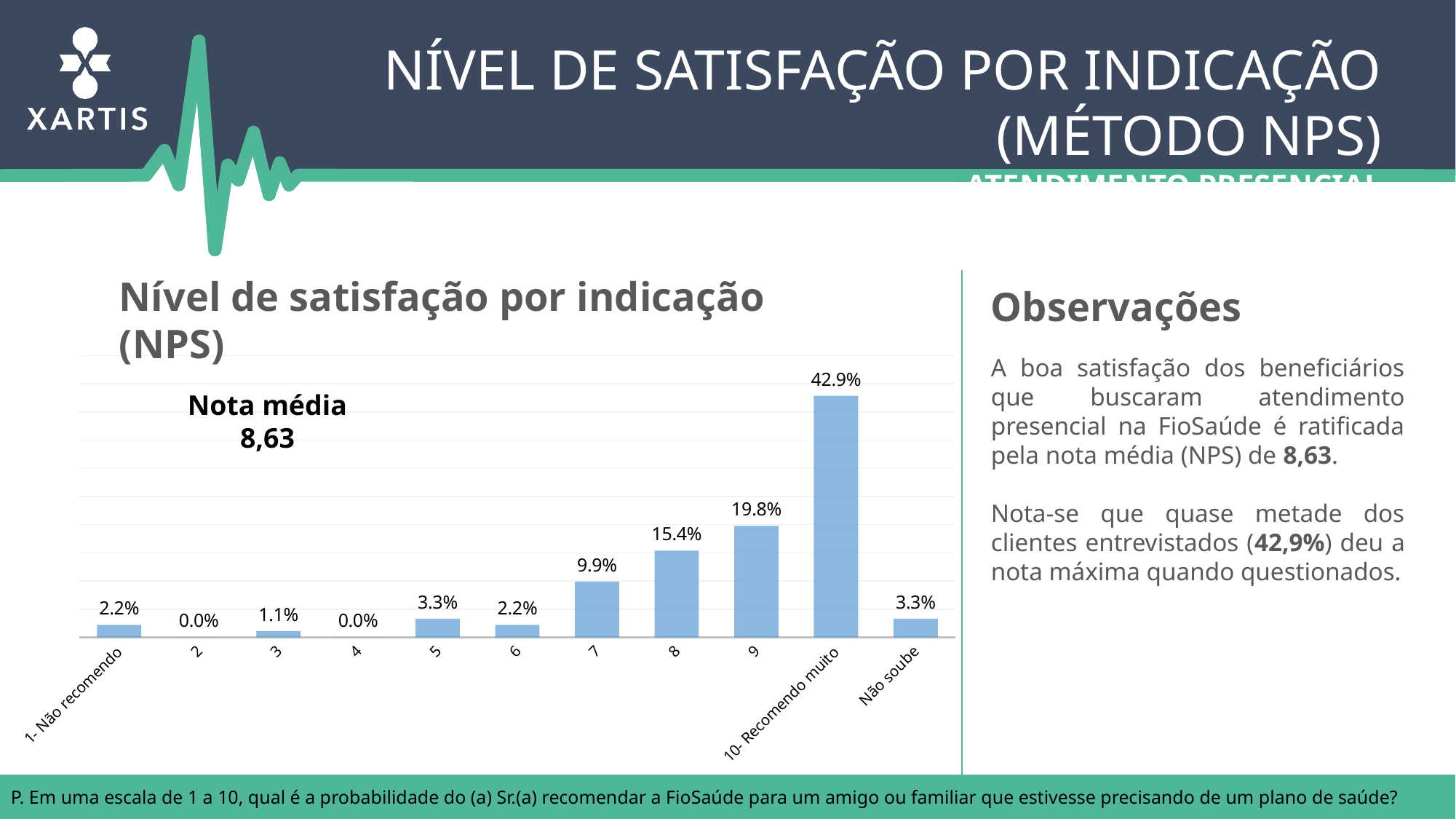
What is the value for "1- Não recomendo"? 2.2% What kind of chart is shown on the slide? Bar chart Which is larger, the value for category 7 or the value for category 8? Category 8 What is the difference between the values for "10- Recomendo muito" and category 9? 23.1% What is the value for category 9? 19.8% What is the value for "10- Recomendo muito"? 42.9% How many categories are shown on the x axis? 11 Which categories have a value of 0.0%? 2 and 4 What is the value for category 8? 15.4% What is the value for "Não soube"? 3.3% What average score (Nota média) is printed on the chart? 8,63 Which category has the highest value? 10- Recomendo muito